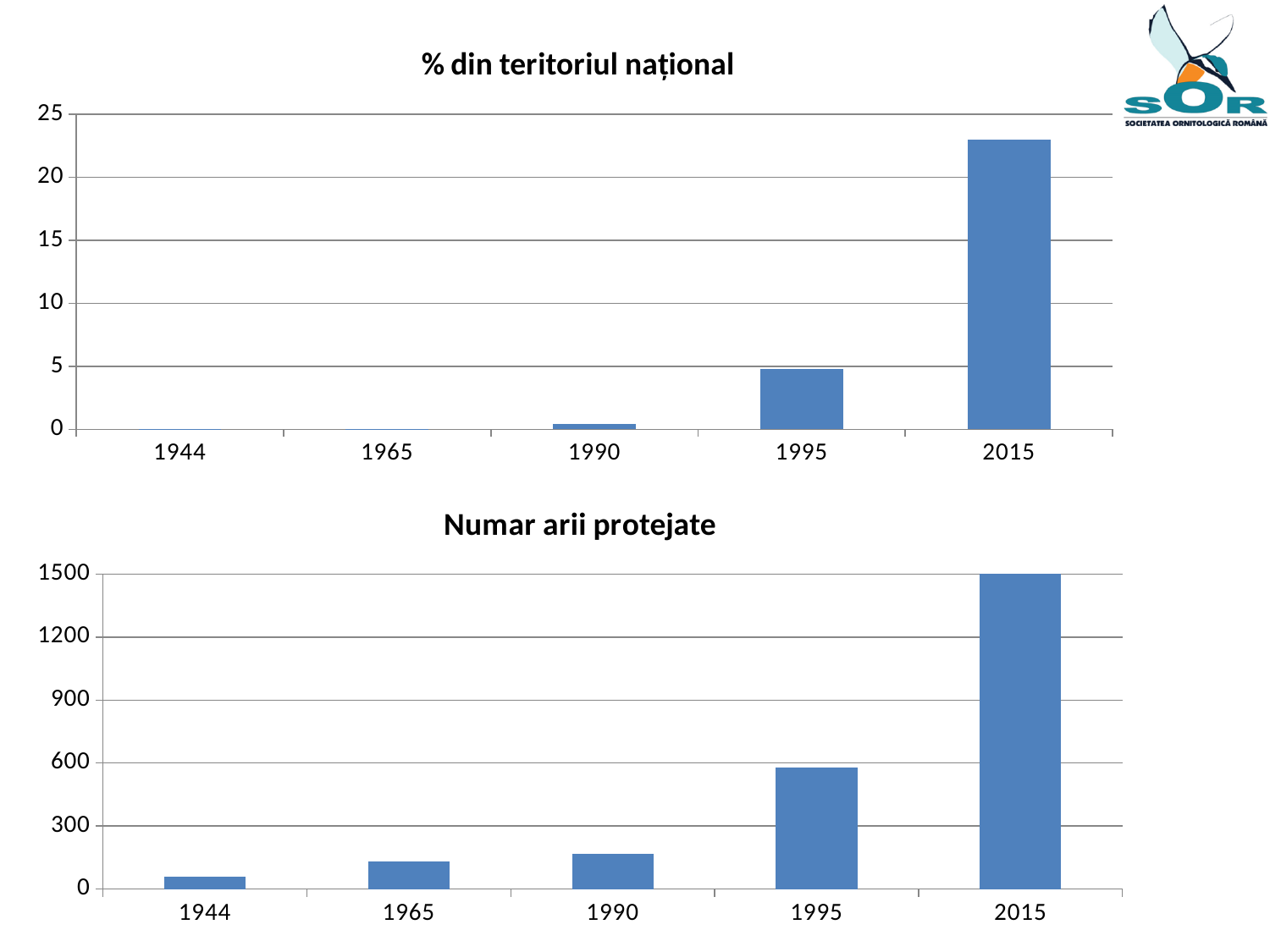
What is the title of the top chart on the slide? % din teritoriul național What kind of chart is the top chart titled '% din teritoriul național'? bar chart In the bottom chart 'Numar arii protejate', which year has the larger value, 1965 or 1995? 1995 In the bottom chart 'Numar arii protejate', do the values rise or fall from 1944 to 2015? rise In the bottom chart 'Numar arii protejate', which year has the highest value? 2015 In the bottom chart 'Numar arii protejate', is the value for 1990 greater or less than 300? less In the top chart '% din teritoriul național', is the value for 2015 greater or less than 20? greater In the top chart '% din teritoriul național', which year has the highest value? 2015 How many years are shown on the x axis of the bottom chart 'Numar arii protejate'? 5 In the bottom chart 'Numar arii protejate', which year has the lowest value? 1944 In the bottom chart 'Numar arii protejate', is the value for 1995 greater or less than 300? greater